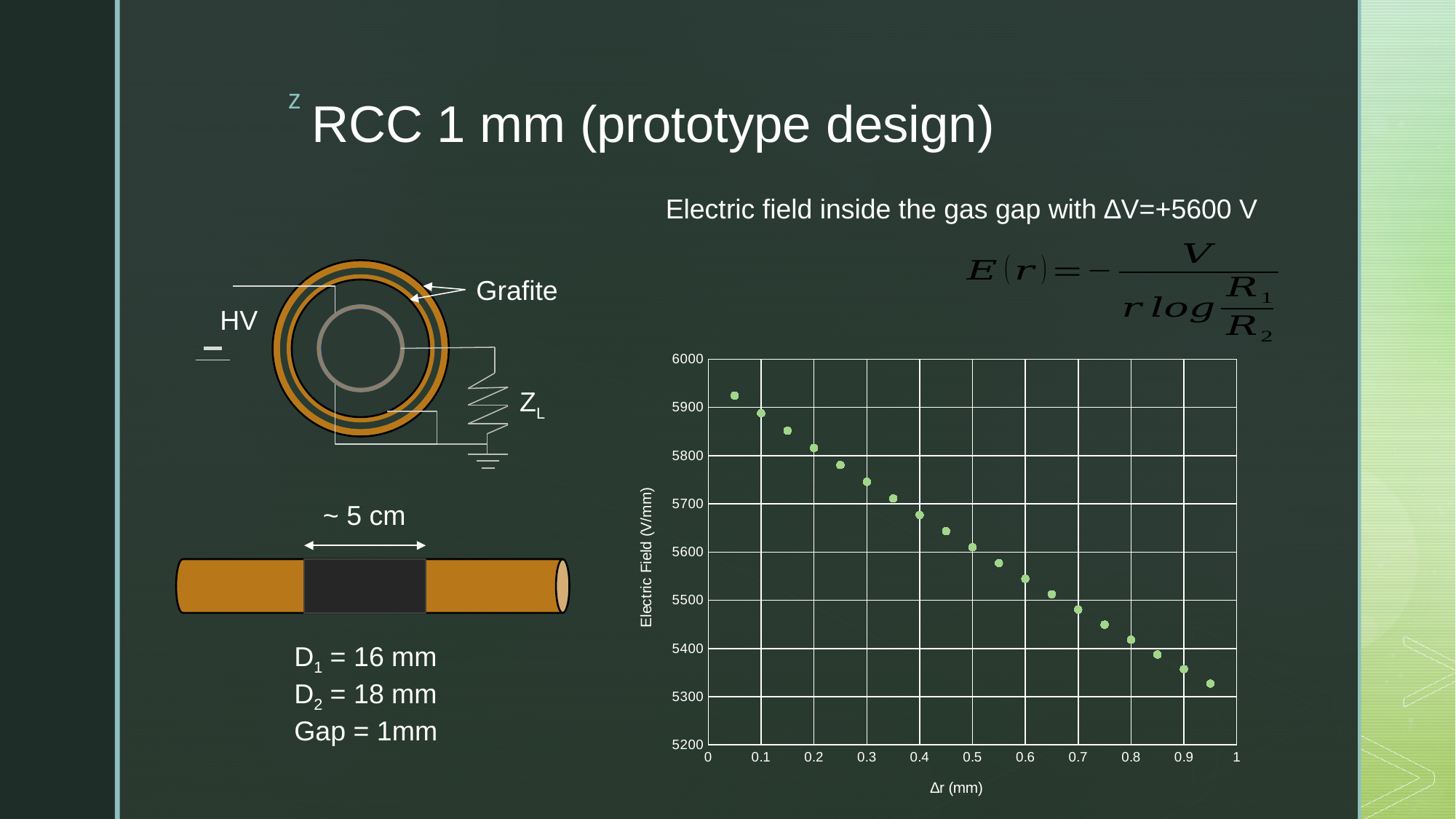
Do the electric field values rise or fall as Δr increases along the x axis? fall Is the electric field at Δr = 0.1 mm greater or less than 5800 V/mm? greater Which has the larger electric field value: Δr = 0.1 mm or Δr = 0.8 mm? Δr = 0.1 mm Is the electric field at Δr = 0.9 mm greater or less than 5400 V/mm? less What is the label of the x axis of the chart? Δr (mm) What is the label of the y axis of the chart? Electric Field (V/mm) What kind of chart is shown on the slide? scatter plot Is the electric field at Δr = 0.3 mm greater or less than 5700 V/mm? greater At which Δr value is the electric field highest? 0.05